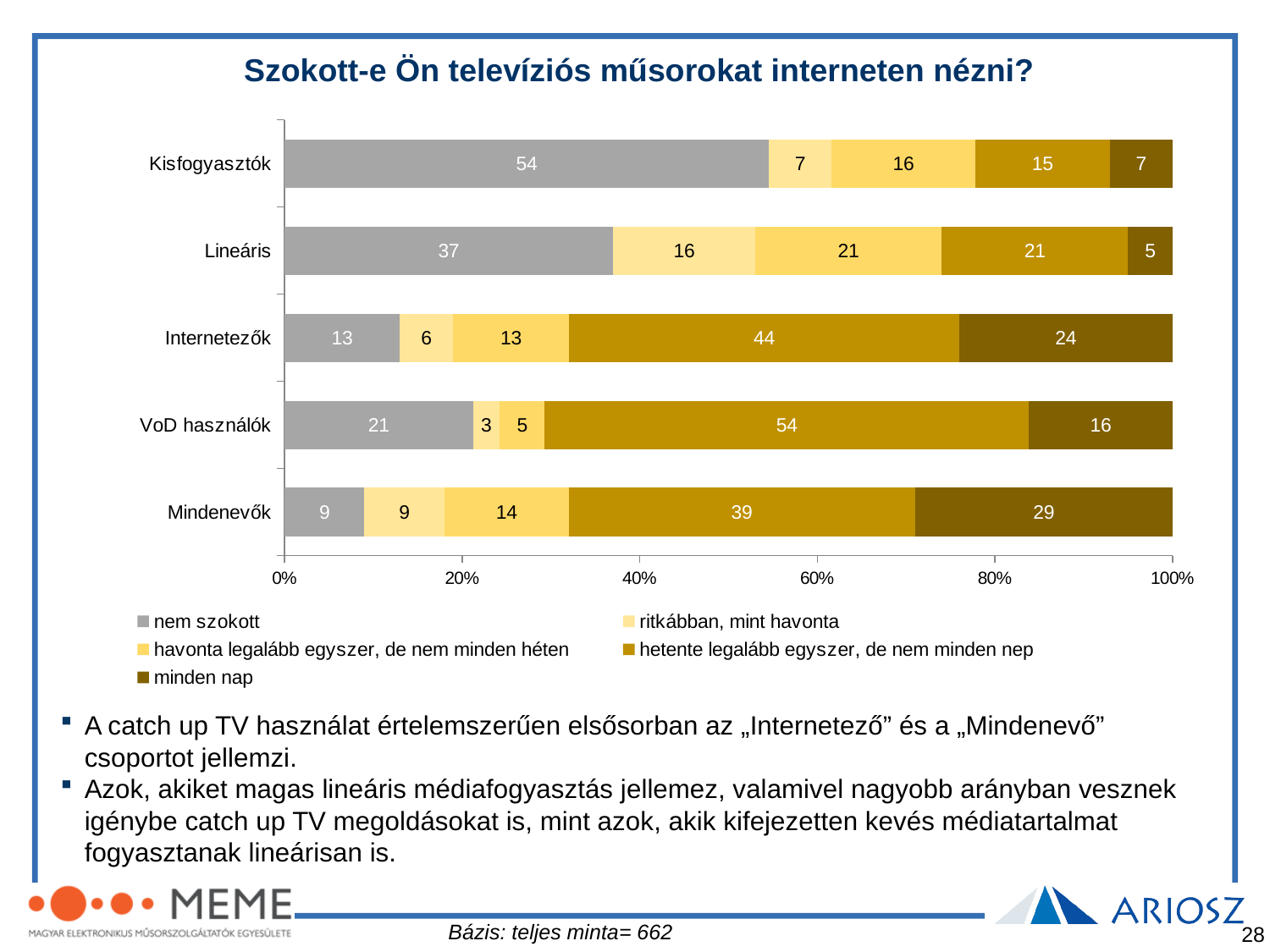
Which category has the lowest value for "nem szokott"? Mindenevők What kind of chart is shown on the slide? Stacked bar chart What is the value for "nem szokott" in the Kisfogyasztók bar? 54 How many categories are shown on the vertical axis of the chart? 5 What is the difference between the "nem szokott" values for Kisfogyasztók and Lineáris? 17 What is the title of the chart? Szokott-e Ön televíziós műsorokat interneten nézni? What is the value for "ritkábban, mint havonta" in the Lineáris bar? 16 How many series does the legend list? 5 Which category has the highest value for "minden nap"? Mindenevők What is the value for "hetente legalább egyszer, de nem minden nap" in the VoD használók bar? 54 What is the value for "minden nap" in the Mindenevők bar? 29 Which is larger: the "hetente legalább egyszer, de nem minden nap" value for Internetezők or for Mindenevők? Internetezők